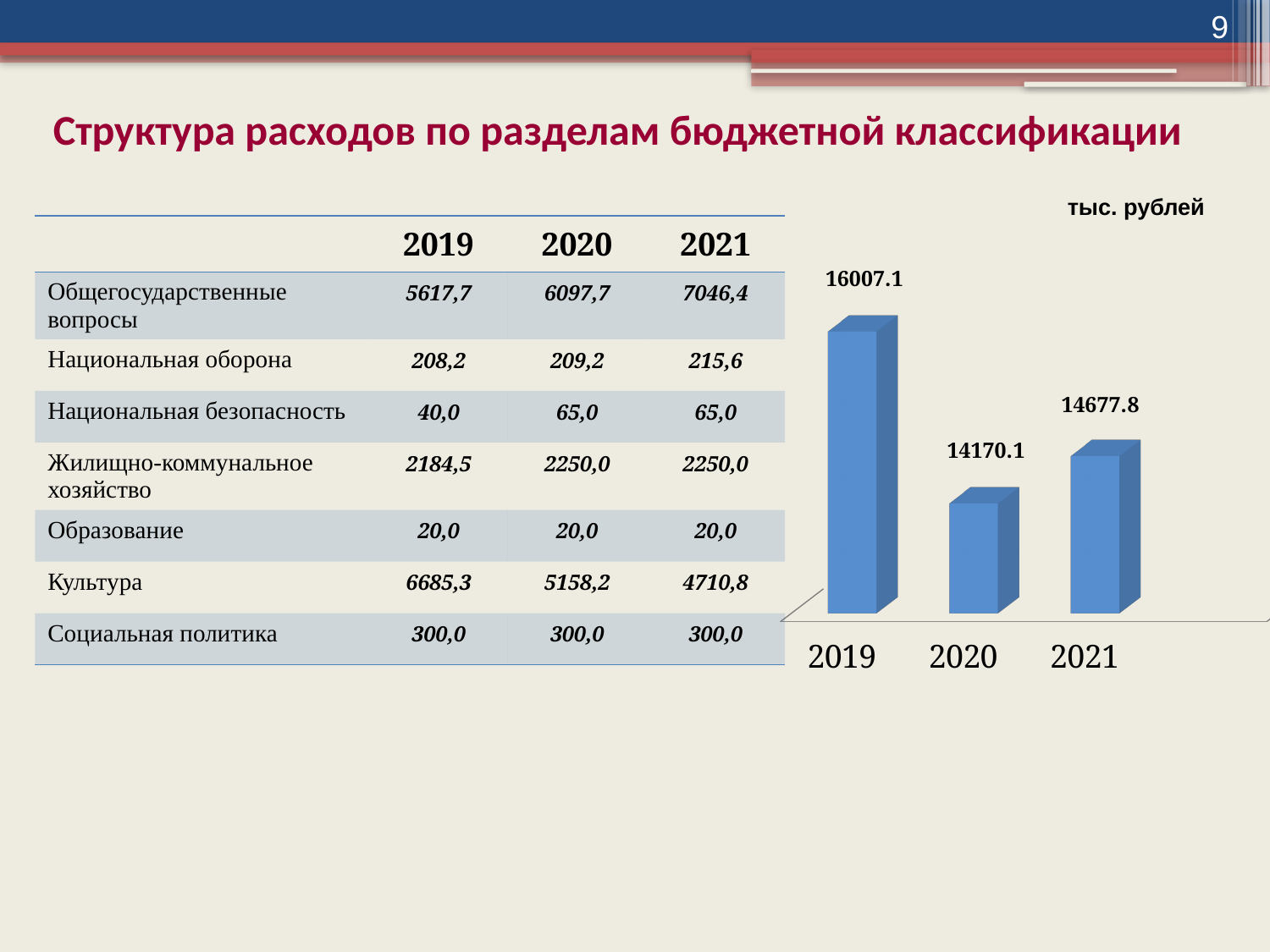
Which year has the highest value on the bar chart? 2019 Which is larger on the bar chart, the value for 2020 or the value for 2021? 2021 What is the difference between the 2019 and 2020 values on the bar chart? 1837.0 What kind of chart is shown on the right of the slide? Bar chart What is the value shown for 2019 on the bar chart? 16007.1 Which year has the lowest value on the bar chart? 2020 What is the value shown for 2020 on the bar chart? 14170.1 What unit is indicated above the bar chart? тыс. рублей What is the value shown for 2021 on the bar chart? 14677.8 How many bars are plotted on the bar chart? 3 What is the difference between the 2019 and 2021 values on the bar chart? 1329.3 What is the difference between the 2021 and 2020 values on the bar chart? 507.7